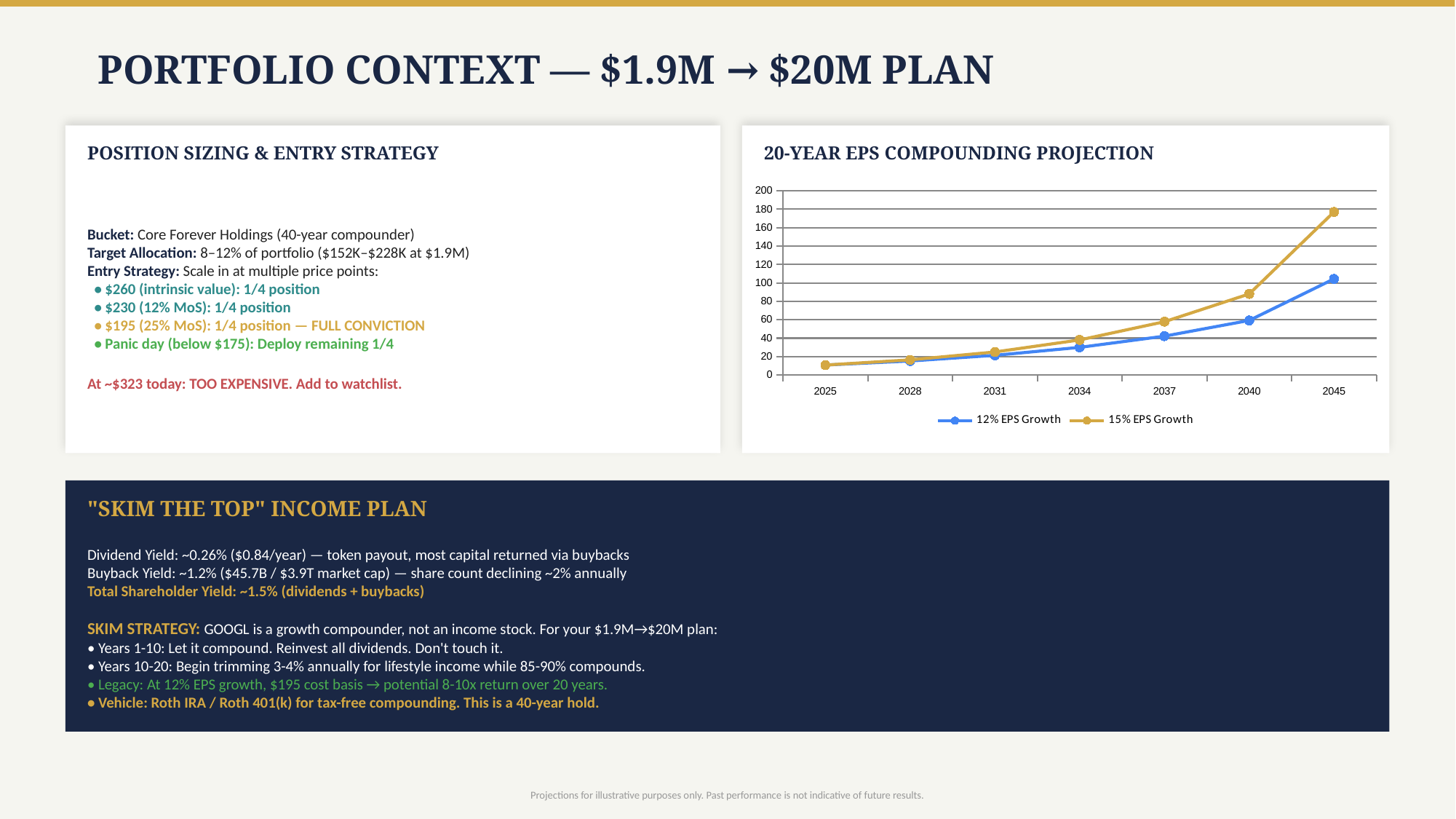
In the 20-Year EPS Compounding Projection chart, do the values rise or fall from 2025 to 2045? rise In the 20-Year EPS Compounding Projection chart, is the 15% EPS Growth value for 2045 greater or less than 160? greater In the 20-Year EPS Compounding Projection chart, which series is higher in 2045? 15% EPS Growth In the 20-Year EPS Compounding Projection chart, is the 12% EPS Growth value for 2045 greater or less than 80? greater How many series does the legend of the 20-Year EPS Compounding Projection chart list? 2 In the 20-Year EPS Compounding Projection chart, is the 15% EPS Growth value for 2037 greater or less than 80? less What kind of chart is the 20-Year EPS Compounding Projection? line chart How many years are labelled on the x axis of the 20-Year EPS Compounding Projection chart? 7 In the 20-Year EPS Compounding Projection chart, what colour is the line for the 15% EPS Growth series? gold What are the two series named in the legend of the 20-Year EPS Compounding Projection chart? 12% EPS Growth and 15% EPS Growth In the 20-Year EPS Compounding Projection chart, in which year does the 15% EPS Growth series reach its highest value? 2045